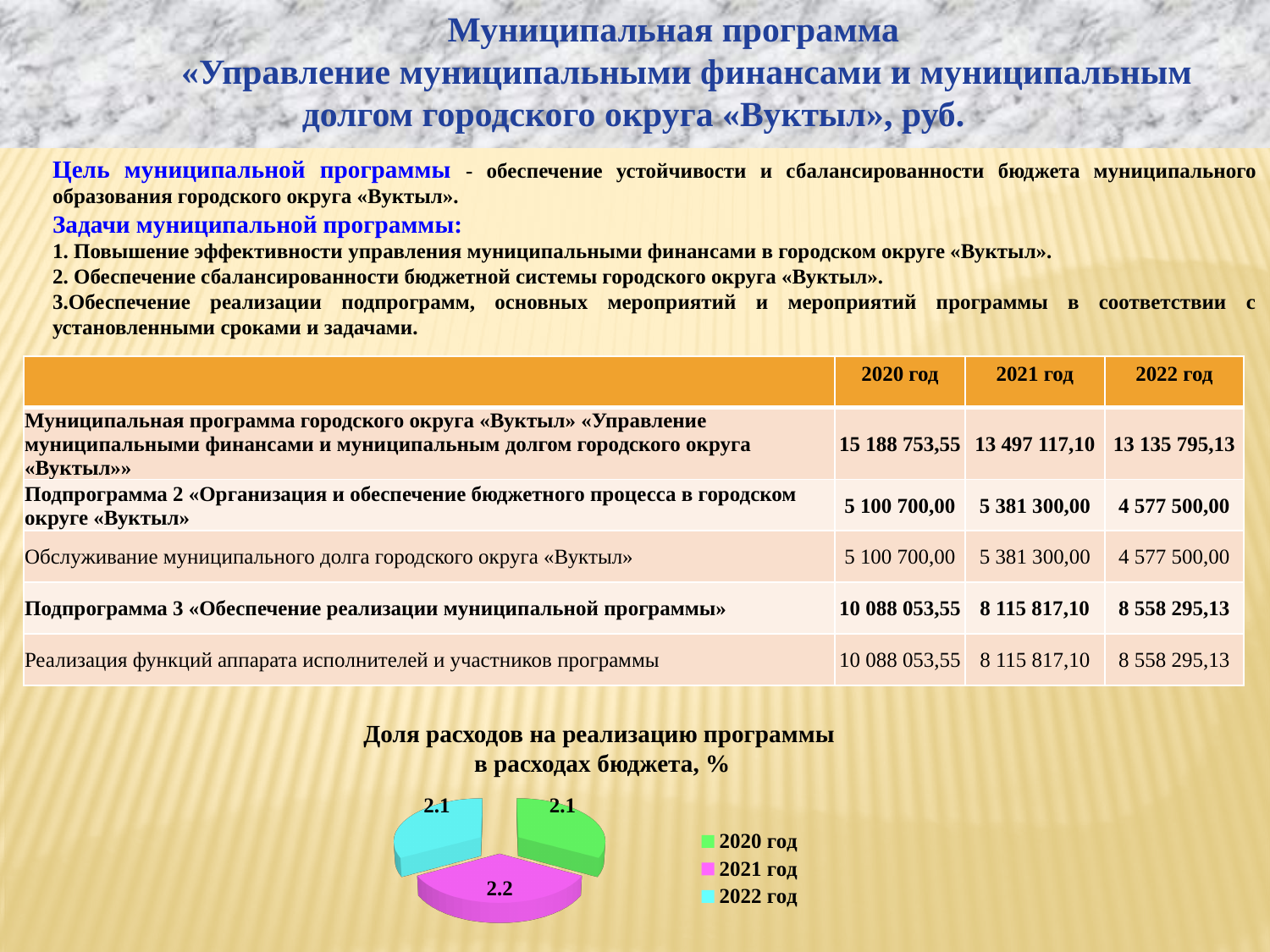
What is the title of the pie chart? Доля расходов на реализацию программы в расходах бюджета, % Which is larger in the pie chart, the value for 2021 год or the value for 2020 год? 2021 год Which year has the largest slice in the pie chart? 2021 год What colour is the slice for 2021 год in the pie chart? Magenta (pink) What is the difference between the values for 2021 год and 2022 год in the pie chart? 0.1 How many entries does the legend of the pie chart list? 3 What is the value for 2021 год in the pie chart? 2.2 What is the value for 2020 год in the pie chart? 2.1 How many slices does the pie chart have? 3 What is the value for 2022 год in the pie chart? 2.1 What type of chart is shown on the slide? Pie chart